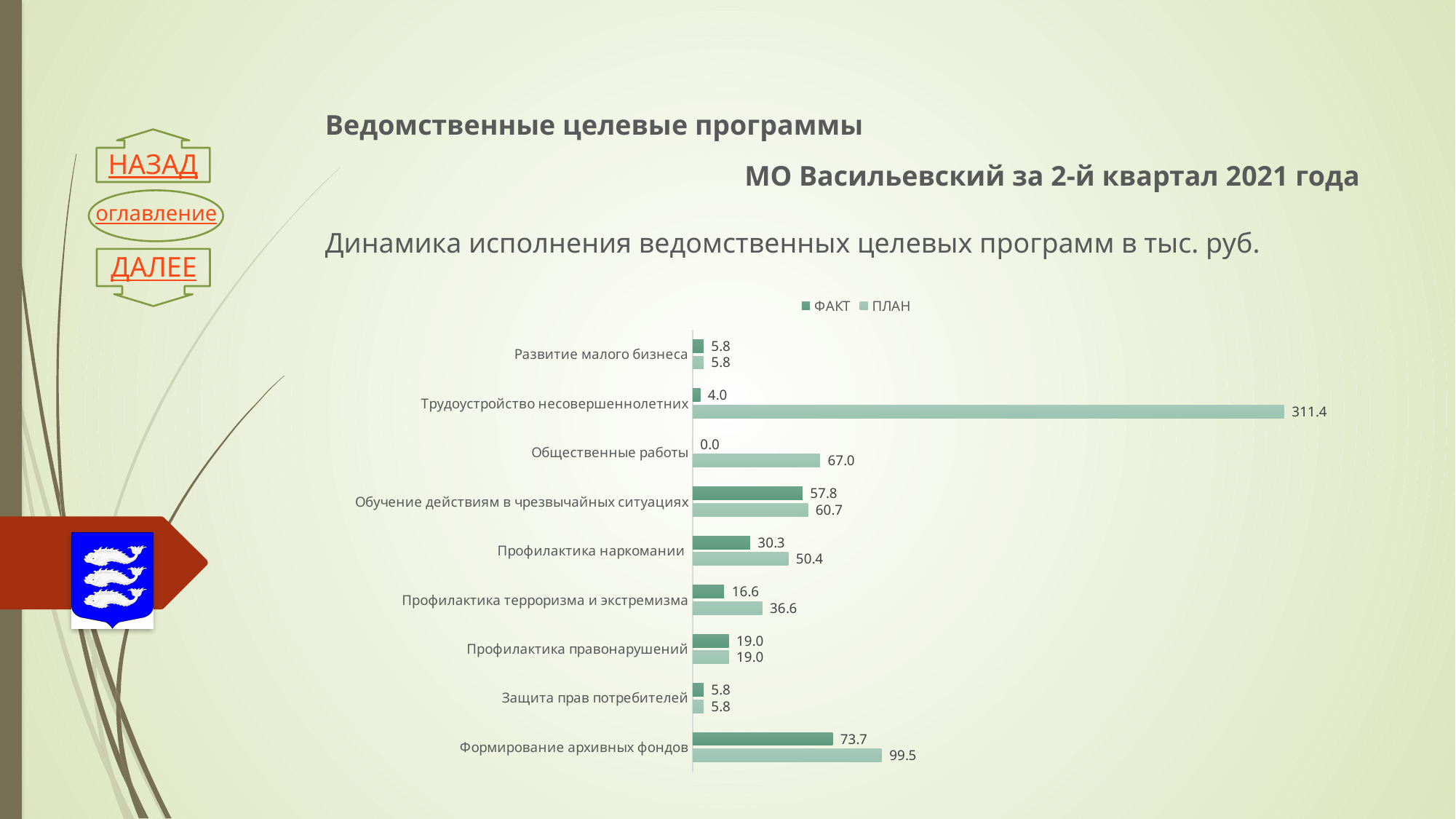
What is the ФАКТ value for Общественные работы? 0.0 What type of chart is shown on the slide? Bar chart What is the ФАКТ value for Формирование архивных фондов? 73.7 Which is larger: the ФАКТ value for Обучение действиям в чрезвычайных ситуациях or the ФАКТ value for Профилактика наркомании? Обучение действиям в чрезвычайных ситуациях How many series does the legend list? 2 What is the difference between the ПЛАН and ФАКТ values for Формирование архивных фондов? 25.8 How many categories are shown in the chart? 9 What is the ПЛАН value for Трудоустройство несовершеннолетних? 311.4 What is the ПЛАН value for Профилактика наркомании? 50.4 What is the difference between the ПЛАН and ФАКТ values for Профилактика терроризма и экстремизма? 20.0 Which category has the lowest ФАКТ value? Общественные работы Which category has the highest ПЛАН value? Трудоустройство несовершеннолетних